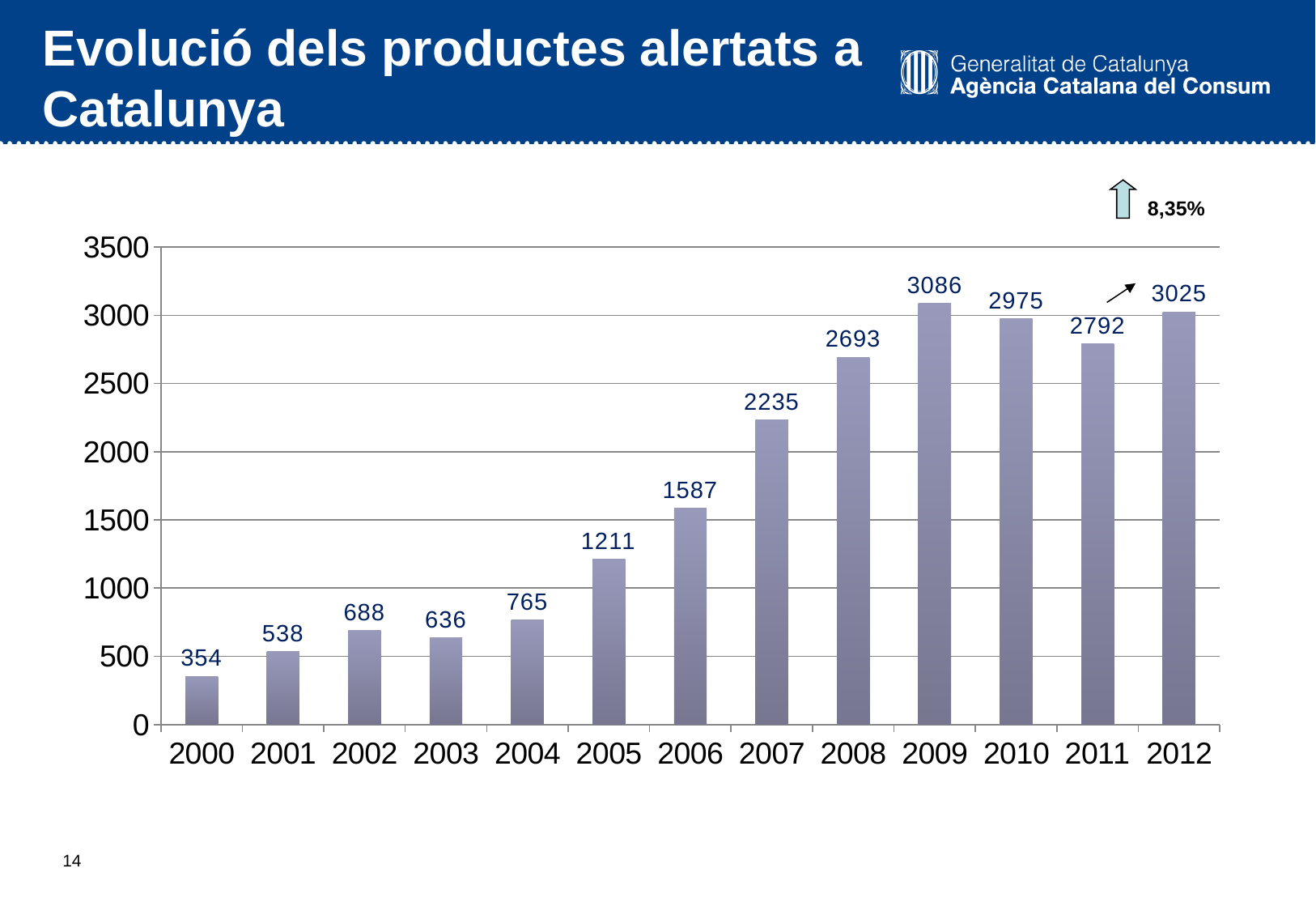
Do the values generally rise or fall from 2000 to 2009? rise Is the value for 2007 greater or less than 2000? greater What is the value for 2012? 3025 Which year has the highest value? 2009 Which year has the lowest value? 2000 What is the value for 2000? 354 Which is larger, the value for 2002 or the value for 2003? 2002 What is the difference between the values for 2012 and 2011? 233 What kind of chart is shown on the slide? bar chart What percentage is shown next to the arrow at the top right of the chart? 8,35% What is the value for 2009? 3086 How many years are shown on the x axis? 13